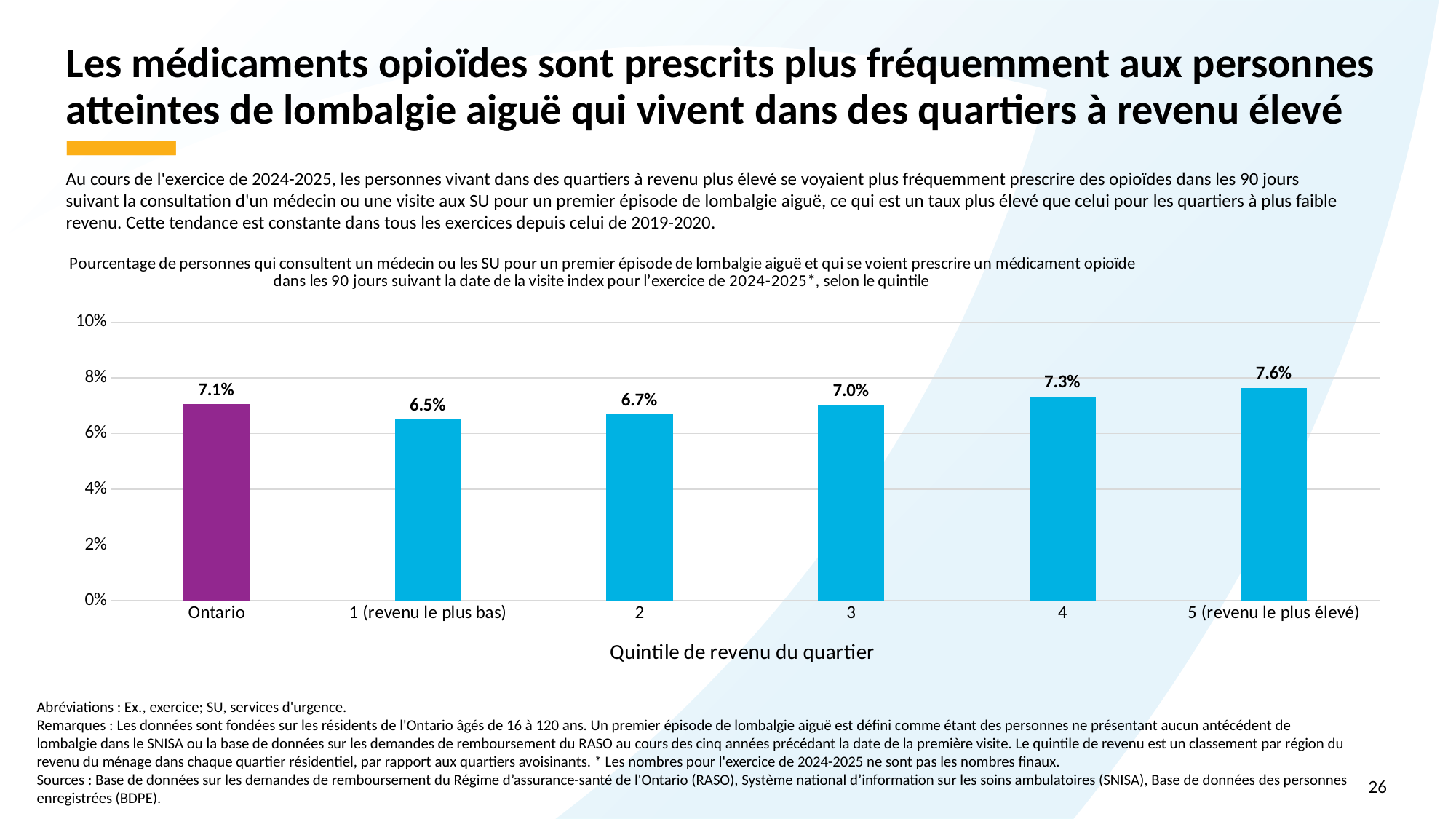
Which is larger, the value for Ontario or the value for quintile 4? 4 Which category has the lowest value? 1 (revenu le plus bas) What is the value for quintile 3? 7.0% What is the difference between the values for quintile 5 (revenu le plus élevé) and quintile 1 (revenu le plus bas)? 1.1% What is the value for quintile 5 (revenu le plus élevé)? 7.6% How many bars are shown in the chart? 6 Is the value for quintile 2 greater or less than 8%? less Which category has the highest value? 5 (revenu le plus élevé) What is the value for Ontario? 7.1% What is the value for quintile 1 (revenu le plus bas)? 6.5% Do the values rise or fall from quintile 1 to quintile 5? rise What kind of chart is shown on the slide? bar chart